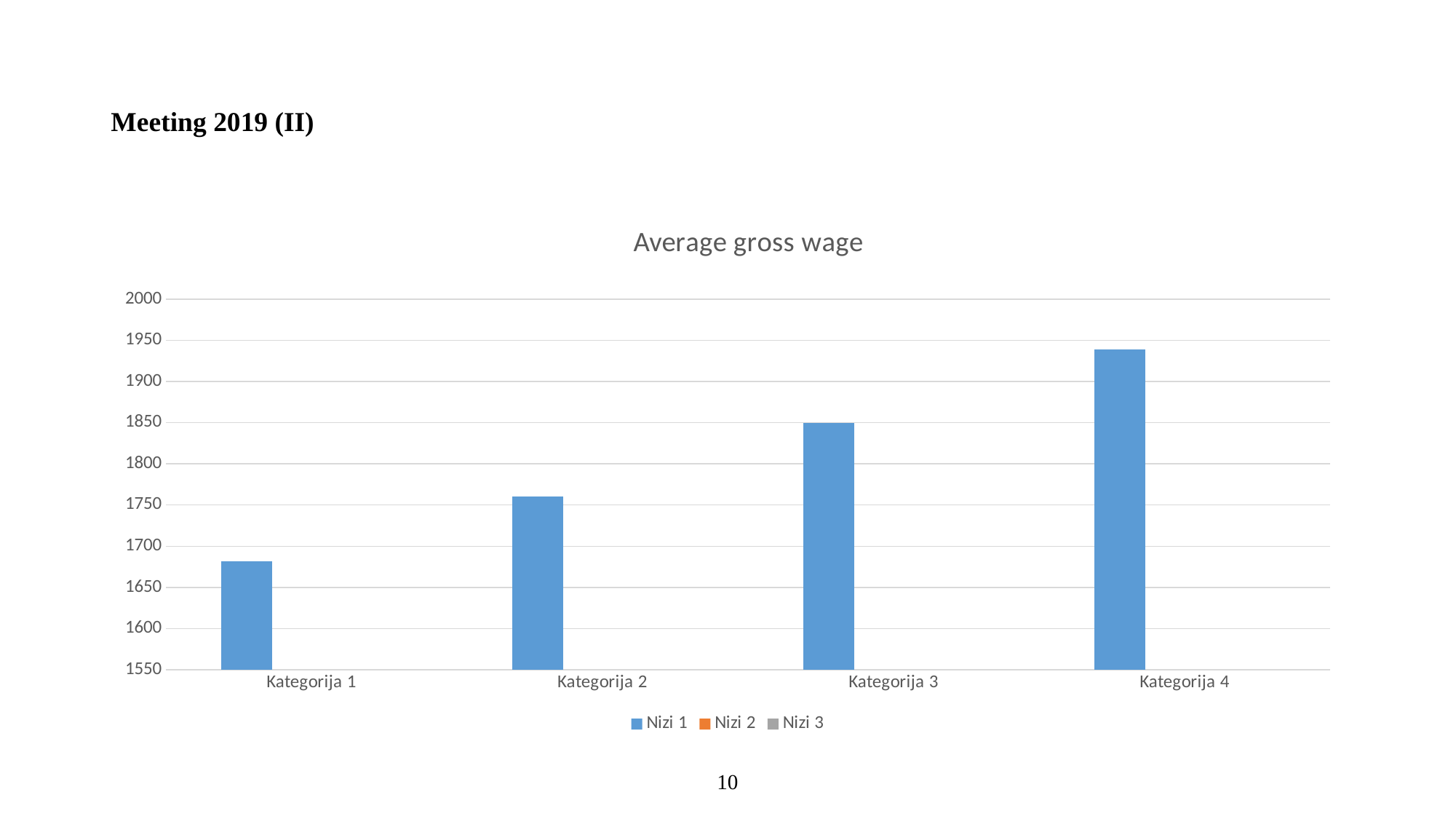
Which category has the highest bar in the chart? Kategorija 4 Is the value for Kategorija 3 greater or less than 1800? greater How many categories are shown on the x axis of the chart? 4 Do the values rise or fall from Kategorija 1 to Kategorija 4? rise Is the value for Kategorija 1 greater or less than 1700? less What is the title of the chart? Average gross wage How many series does the chart's legend list? 3 Which category has the lowest bar in the chart? Kategorija 1 Is the value for Kategorija 4 greater or less than 1900? greater Which is larger, the value for Kategorija 2 or the value for Kategorija 3? Kategorija 3 What kind of chart is shown on the slide? bar chart